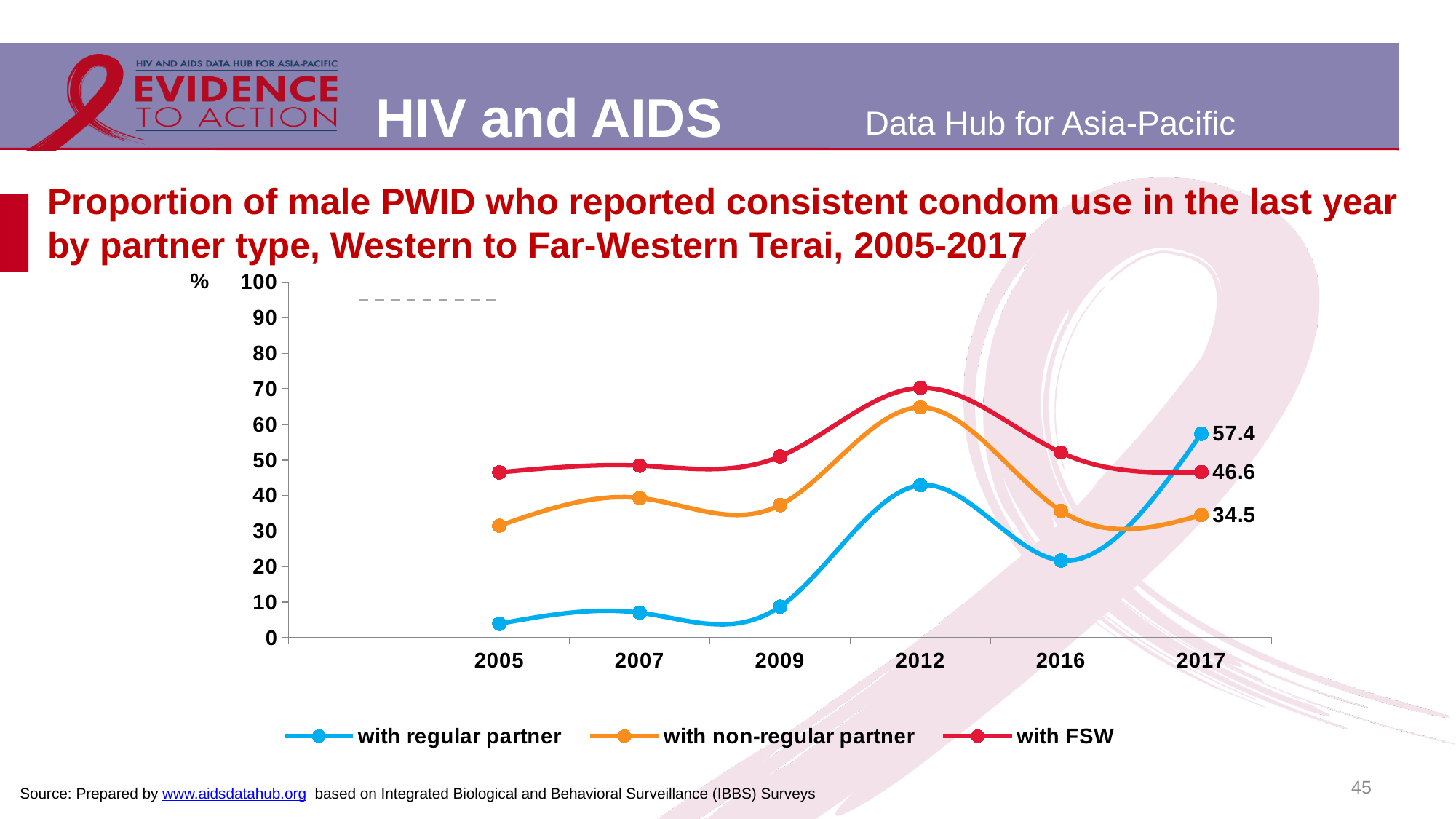
What is the value for 'with non-regular partner' in 2017? 34.5 How many years are shown on the x axis? 6 Is the value for 'with FSW' in 2012 greater or less than 60? greater In 2017, which series has the higher value: 'with regular partner' or 'with FSW'? with regular partner What is the difference between the 2017 values for 'with regular partner' and 'with non-regular partner'? 22.9 What kind of chart is shown on the slide? line chart Which series has the highest value in 2017? with regular partner What is the value for 'with FSW' in 2017? 46.6 In which year does the 'with FSW' series reach its highest value? 2012 What is the value for 'with regular partner' in 2017? 57.4 Is the value for 'with regular partner' in 2005 greater or less than 10? less How many series does the legend list? 3